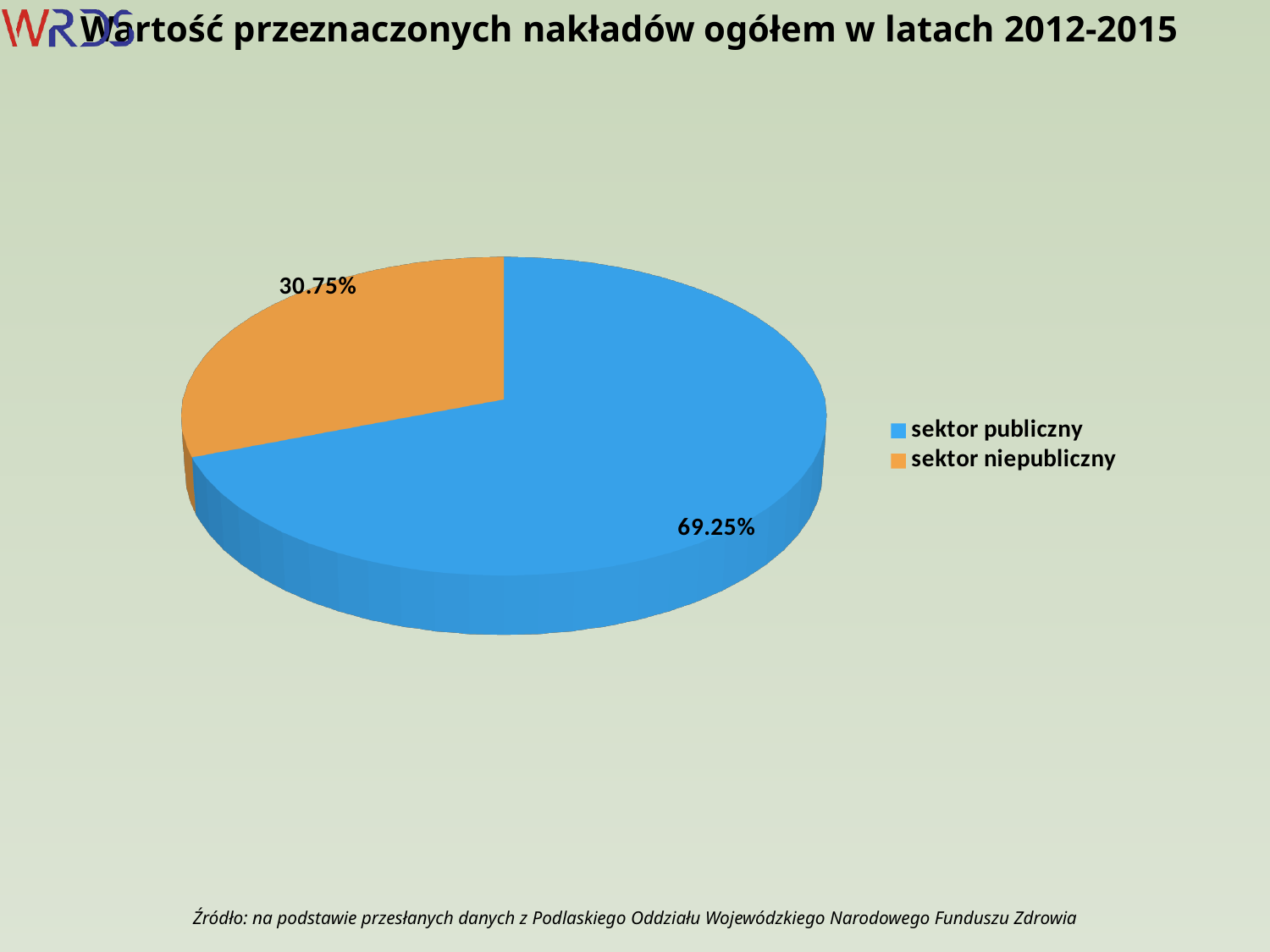
Which sector has the smallest slice of the pie? sektor niepubliczny Which sector has the largest slice of the pie? sektor publiczny How many entries does the legend list? 2 What is the difference in percentage points between sektor publiczny and sektor niepubliczny? 38.5 What kind of chart is shown on the slide? pie chart What colour is the slice for sektor niepubliczny? orange How many slices does the pie chart have? 2 What share of the pie does sektor niepubliczny have? 30.75% Which is larger, the share for sektor publiczny or for sektor niepubliczny? sektor publiczny What share of the pie does sektor publiczny have? 69.25% What is the title of the chart? Wartość przeznaczonych nakładów ogółem w latach 2012-2015